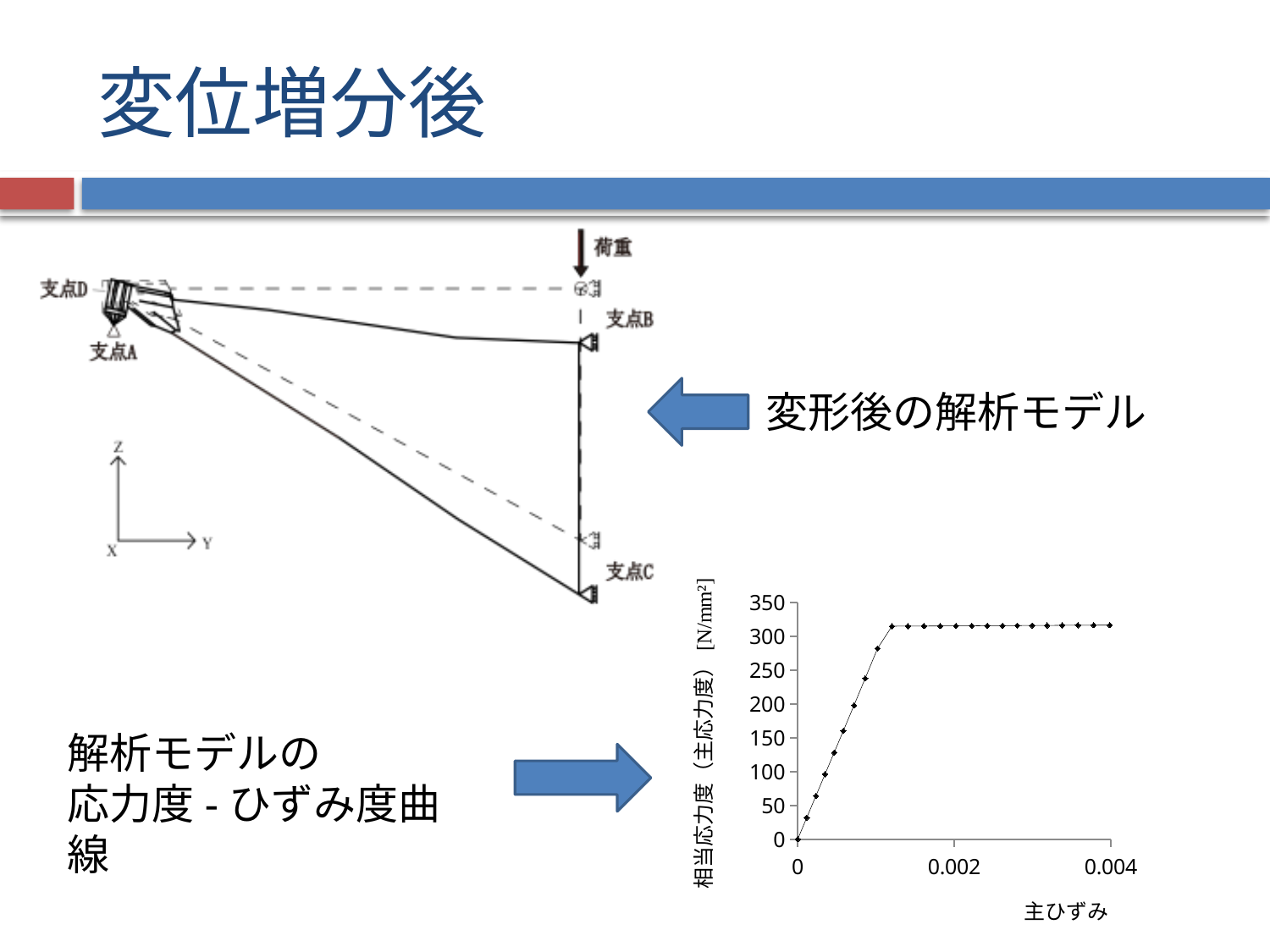
In the stress-strain chart, is the stress at a strain of 0.002 larger or smaller than the stress at a strain of 0.0005? larger What kind of chart is shown at the bottom right of the slide? line chart What is the label of the x axis of the stress-strain chart? 主ひずみ In the stress-strain chart, is the stress value at a strain of 0.003 greater or less than 250? greater In the stress-strain chart, does the curve keep rising or stay flat between strains of 0.002 and 0.004? stay flat In the stress-strain chart, is the stress value at a strain of 0.002 greater or less than 300? greater In the stress-strain chart, do the values rise or fall as the strain increases from 0 to about 0.001? rise In the stress-strain chart, is the stress value at a strain of 0.004 greater or less than 350? less What is the highest tick value shown on the y axis of the stress-strain chart? 350